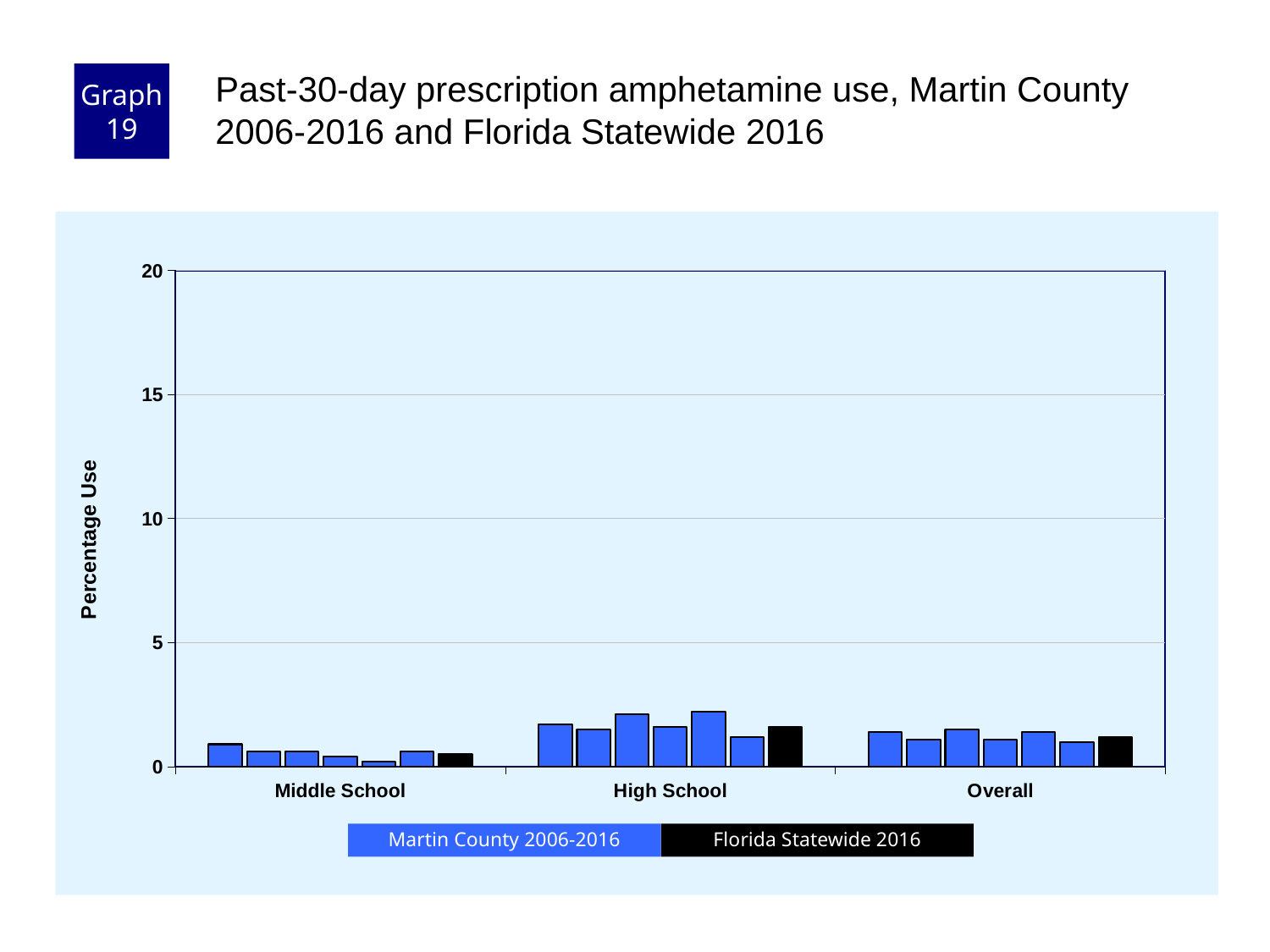
What is the label of the y axis? Percentage Use How many series does the legend list? 2 Which category has the tallest bars overall? High School Is the Florida Statewide 2016 value for Middle School greater or less than 5? less Is the Florida Statewide 2016 value larger for Overall or for Middle School? Overall Which series is shown in black in the legend? Florida Statewide 2016 Is the Florida Statewide 2016 value for High School greater or less than 5? less Which category has the shortest bars overall? Middle School What kind of chart is shown on the slide? bar chart Is the Florida Statewide 2016 value for Overall greater or less than 10? less How many categories are shown on the x axis? 3 Is the Florida Statewide 2016 value larger for High School or for Middle School? High School